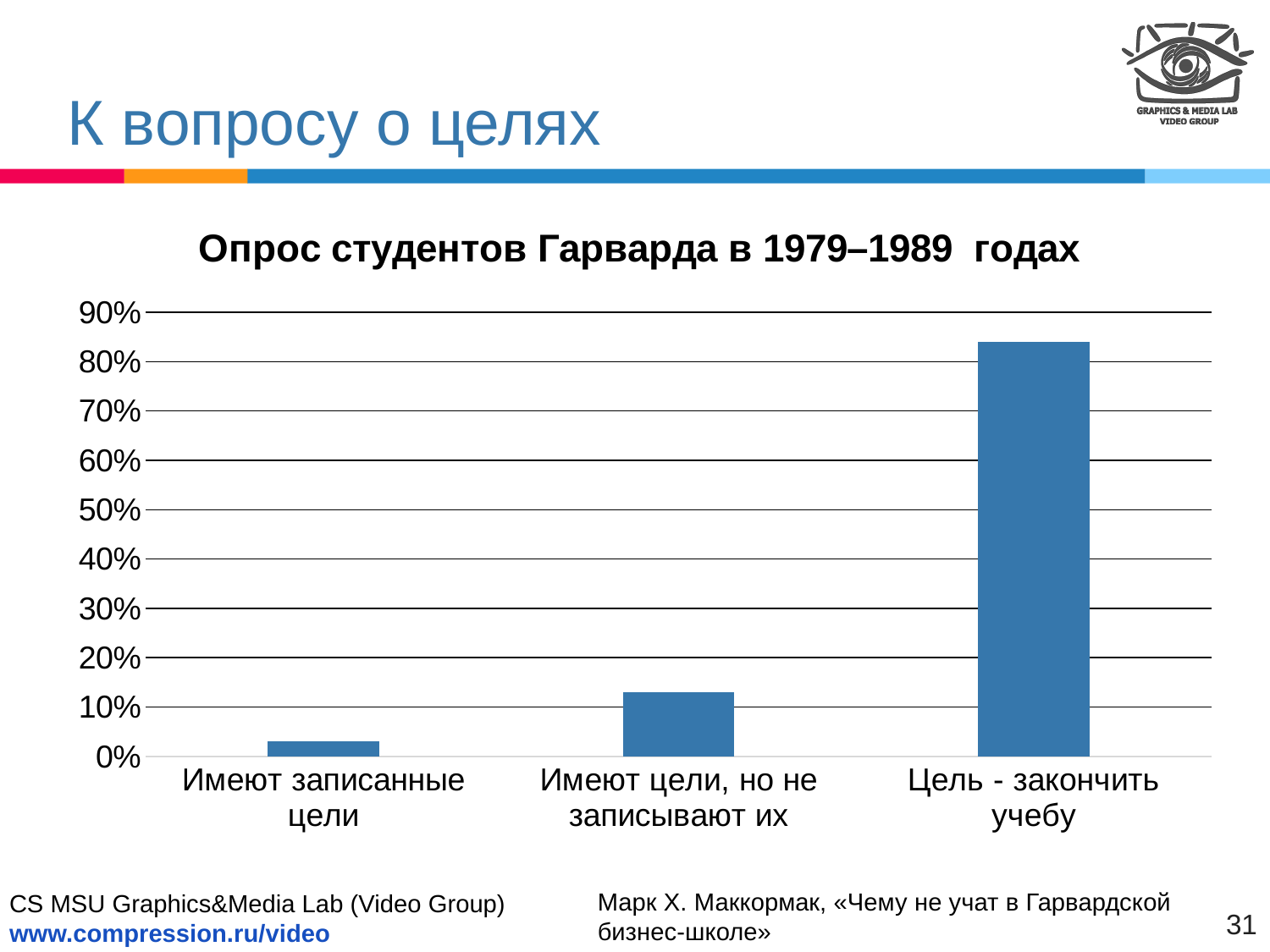
Is the value for "Цель - закончить учебу" greater or less than 80%? greater Which category has the highest value? Цель - закончить учебу Is the value for "Имеют цели, но не записывают их" greater or less than 20%? less Is the value for "Имеют цели, но не записывают их" greater or less than 10%? greater Do the values rise or fall from left to right along the x axis? rise How many categories are shown on the x axis of the chart? 3 Which category has the lowest value? Имеют записанные цели What is the title of the chart? Опрос студентов Гарварда в 1979–1989 годах Which is larger: the value for "Имеют записанные цели" or the value for "Имеют цели, но не записывают их"? Имеют цели, но не записывают их What kind of chart is shown on the slide? bar chart What is the highest value shown on the y axis of the chart? 90%